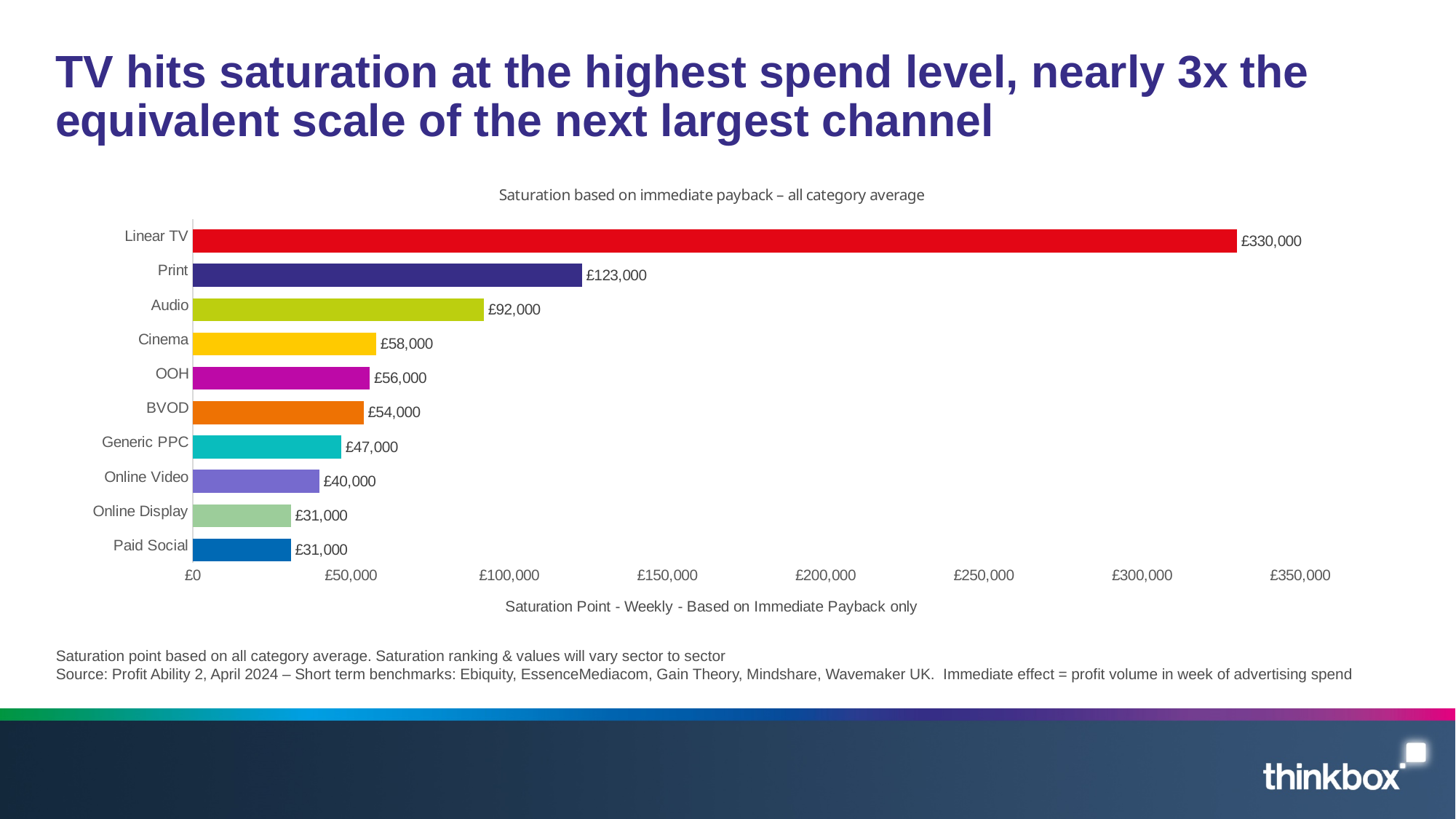
Which has a higher saturation point, Online Video or Generic PPC? Generic PPC What is the saturation point for Generic PPC? £47,000 Is the saturation point for Print greater or less than £100,000? greater How many channels are shown in the chart? 10 What is the title of the chart? Saturation based on immediate payback – all category average Which channel has the highest saturation point? Linear TV Which has a higher saturation point, Print or Audio? Print What is the saturation point for Audio? £92,000 What is the difference between the saturation points of Linear TV and Print? £207,000 What kind of chart is shown on the slide? Bar chart What is the saturation point for Linear TV? £330,000 What is the difference between the saturation points of Cinema and BVOD? £4,000